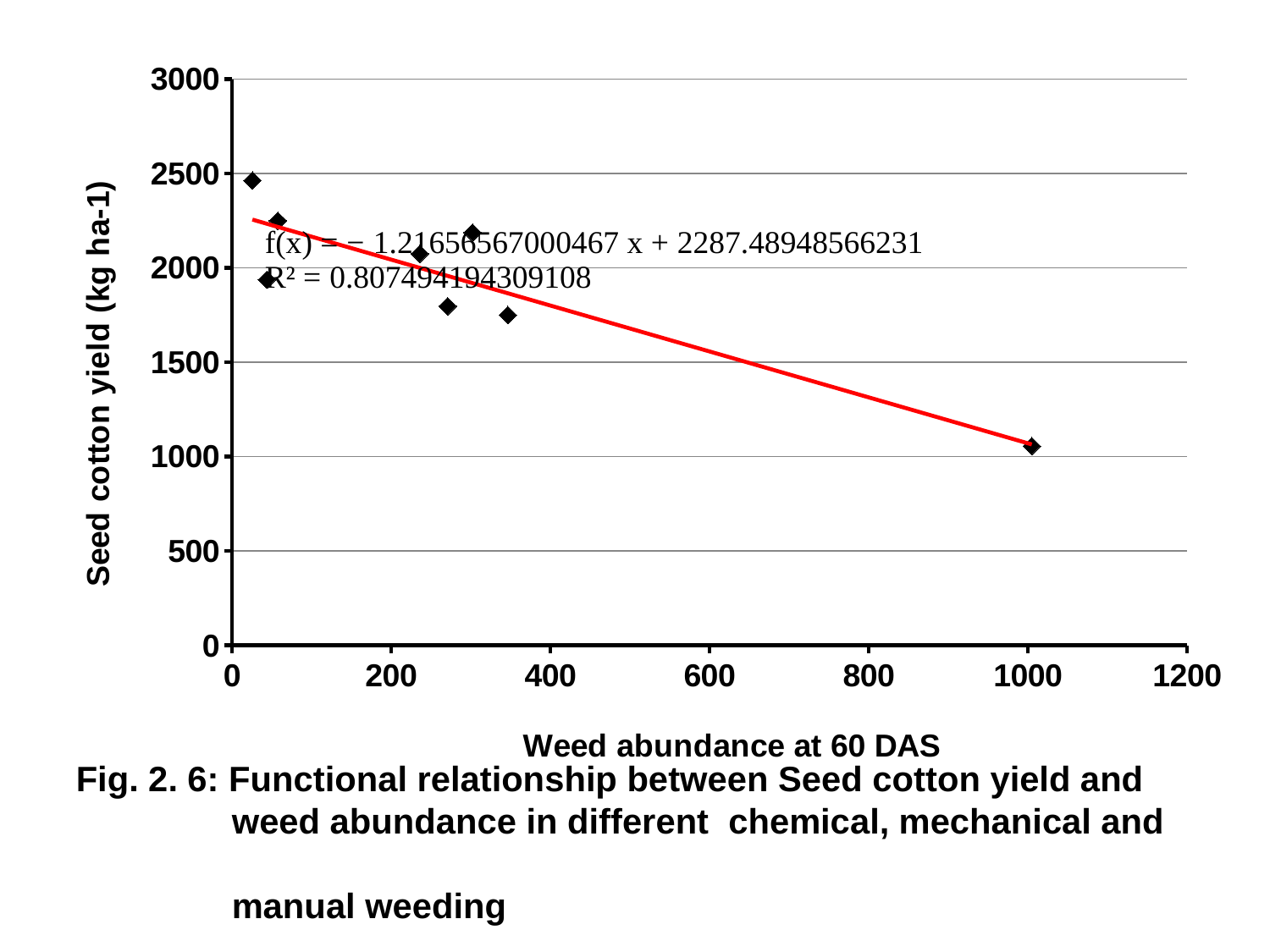
Is the seed cotton yield for the point with the lowest weed abundance greater or less than 2000? greater What is the title of the y axis? Seed cotton yield (kg ha-1) Which point has the lowest seed cotton yield: the one at a weed abundance of about 1000 or the one at about 350? The one at about 1000 What is the intercept in the fitted equation printed on the chart? 2287.48948566231 How many data points are plotted on the chart? 8 Is the seed cotton yield for the point at a weed abundance of about 1000 greater or less than 1500? less What is the R² value printed on the chart? 0.807494194309108 What kind of chart is shown on the slide? Scatter chart Does seed cotton yield rise or fall as weed abundance increases along the x axis? Fall What is the title of the x axis? Weed abundance at 60 DAS What is the slope in the fitted equation printed on the chart? -1.21656567000467 What is the highest value shown on the x axis? 1200